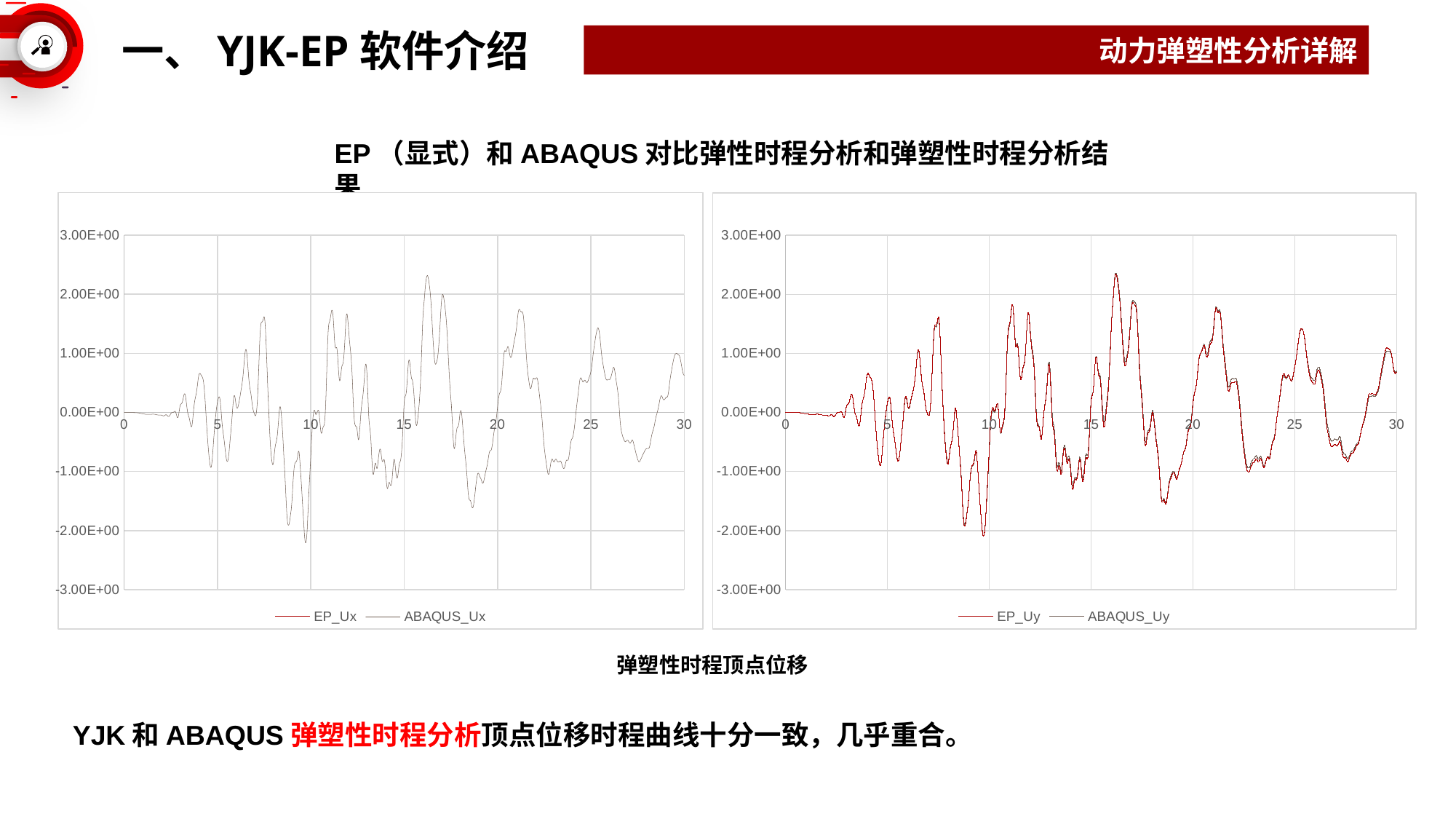
How many series does the legend of the left chart list? 2 In the left chart, is the value of the curves at x = 5 greater or less than 1.00E+00? less What are the two legend entries of the right chart? EP_Uy and ABAQUS_Uy In the right chart, is the highest peak of the curves greater or less than 2.00E+00? greater What kind of chart is the right chart (EP_Uy / ABAQUS_Uy)? line chart In the left chart, is the highest peak of the curves greater or less than 2.00E+00? greater What are the two legend entries of the left chart? EP_Ux and ABAQUS_Ux What kind of chart is the left chart (EP_Ux / ABAQUS_Ux)? line chart How many series does the legend of the right chart list? 2